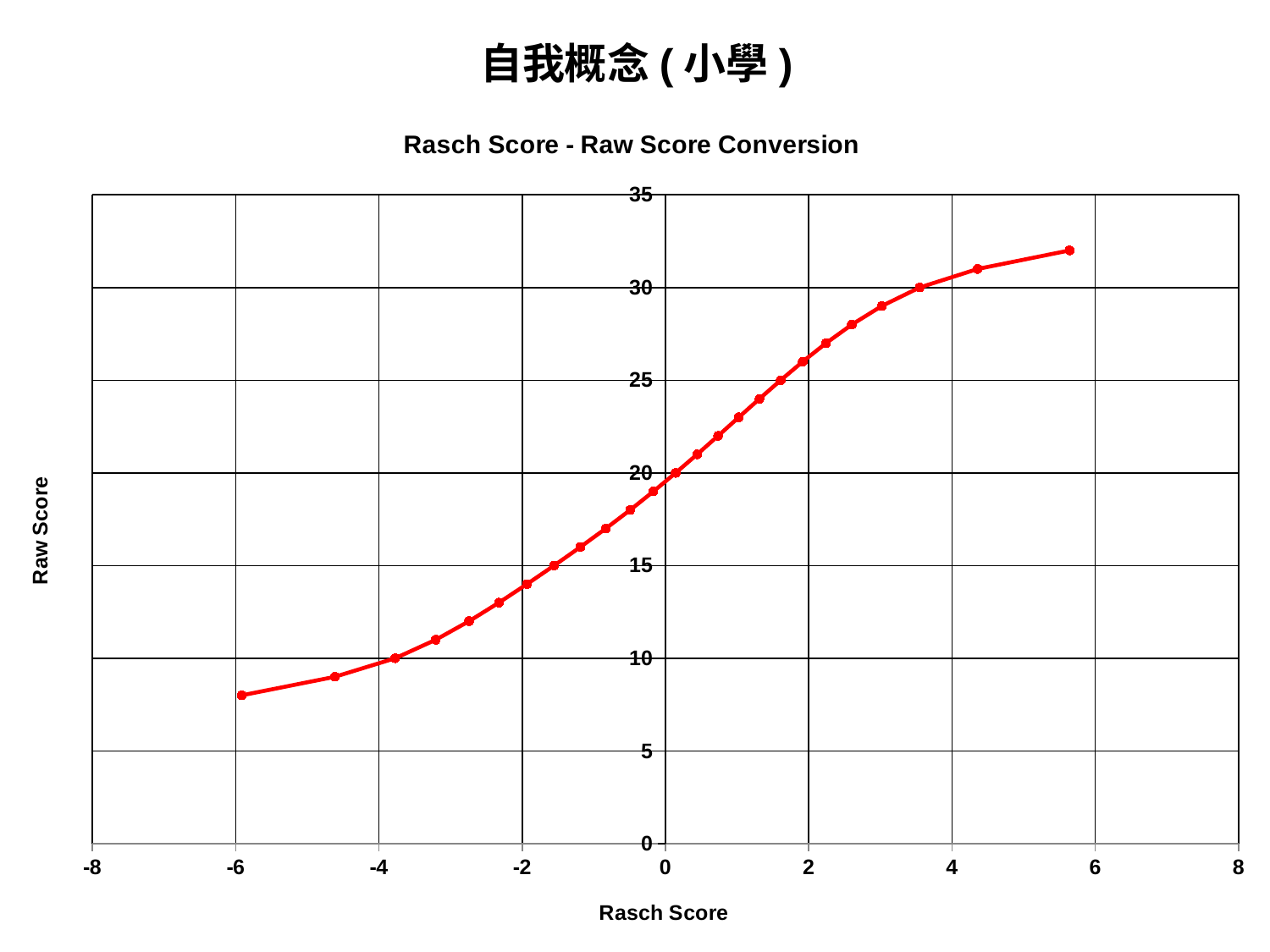
Is the raw score of the rightmost point (highest Rasch score) greater or less than 30? greater How many data points are plotted on the line? 25 What is the label of the vertical axis? Raw Score Is the raw score of the leftmost point (lowest Rasch score) greater or less than 10? less What is the highest value shown on the vertical axis? 35 Is the raw score at a Rasch score of about 2 greater or less than 25? greater What kind of chart is shown on the slide? line chart Which point has the higher raw score: the one at a Rasch score of about -2 or the one at about 4? the one at about 4 Does the raw score rise or fall as the Rasch score increases along the x axis? rise What is the title of the chart? Rasch Score - Raw Score Conversion